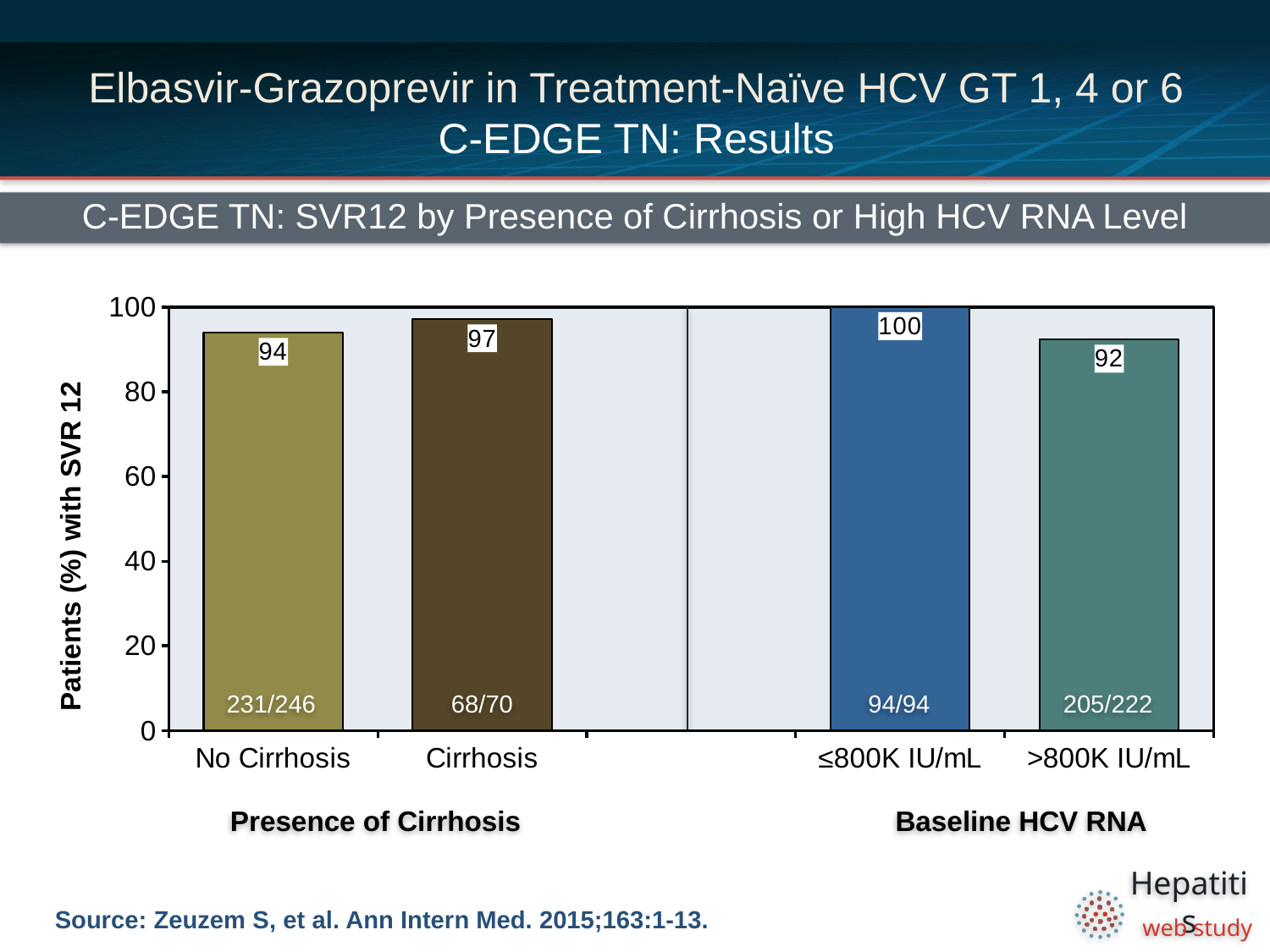
What is the difference in SVR12 rate between the Cirrhosis and No Cirrhosis groups? 3 How many patients achieved SVR12 out of the total in the No Cirrhosis group, as shown on the bar? 231/246 How many bars are shown in the chart? 4 What is the SVR12 rate for patients with baseline HCV RNA ≤800K IU/mL? 100 Which category has the highest SVR12 rate? ≤800K IU/mL What is the SVR12 rate for patients with baseline HCV RNA >800K IU/mL? 92 What is the SVR12 rate for the No Cirrhosis group? 94 What fraction is shown on the >800K IU/mL bar? 205/222 What type of chart is shown on the slide? Bar chart Which category has the lowest SVR12 rate? >800K IU/mL Which has a higher SVR12 rate, ≤800K IU/mL or >800K IU/mL? ≤800K IU/mL What is the SVR12 rate for the Cirrhosis group? 97